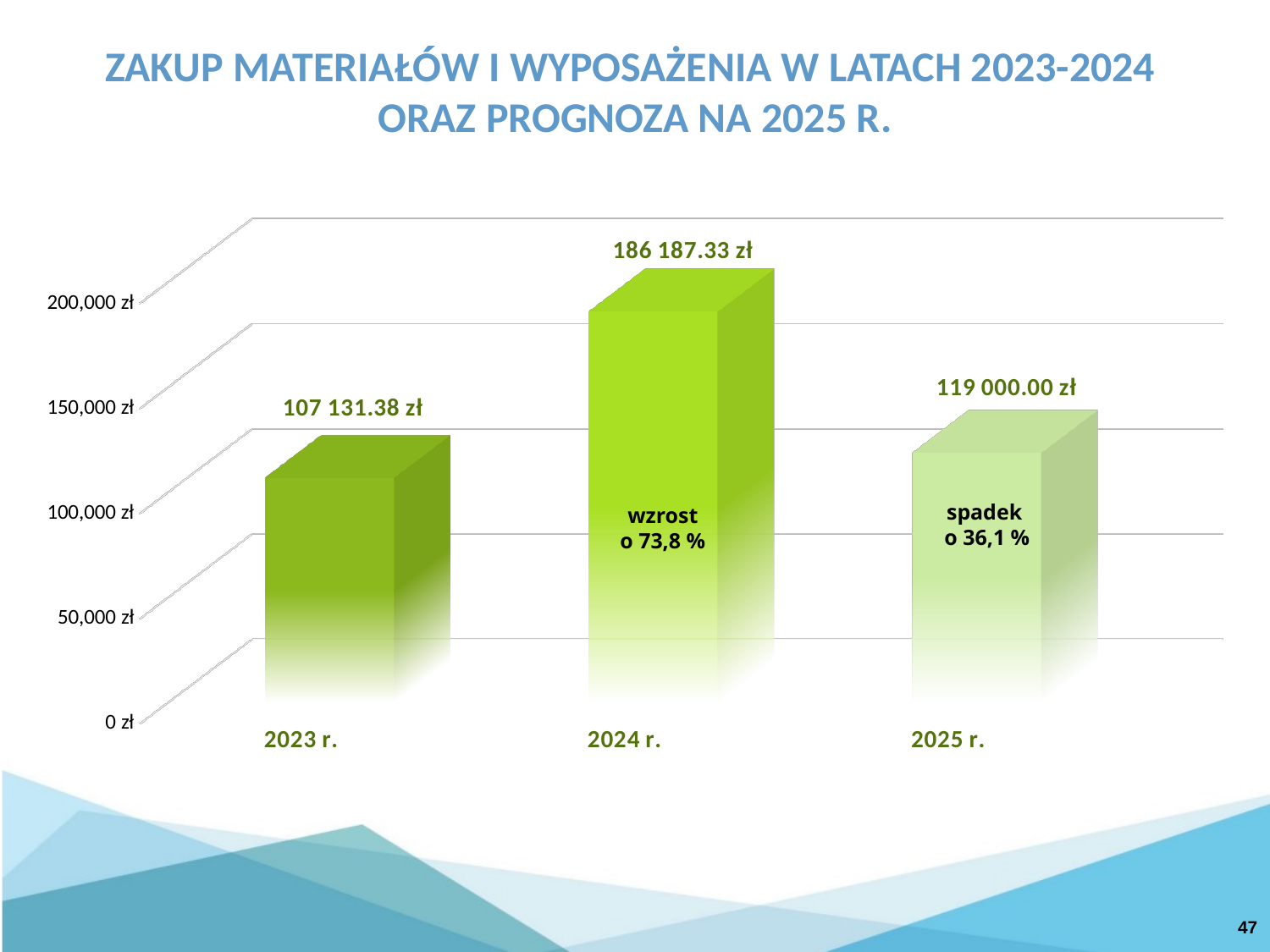
What is the difference between the values for 2024 r. and 2023 r.? 79 055.95 zł Which year has the lowest value? 2023 r. What is the value for 2024 r.? 186 187.33 zł What is the difference between the values for 2024 r. and 2025 r.? 67 187.33 zł Which year has the highest value? 2024 r. What kind of chart is shown on the slide? bar chart What is the value for 2023 r.? 107 131.38 zł What percentage increase is annotated on the 2024 r. bar? wzrost o 73,8 % Is the value for 2024 r. greater or less than 150,000 zł? greater What is the value for 2025 r.? 119 000.00 zł Which is larger, the value for 2025 r. or the value for 2023 r.? 2025 r. How many years are shown on the chart? 3